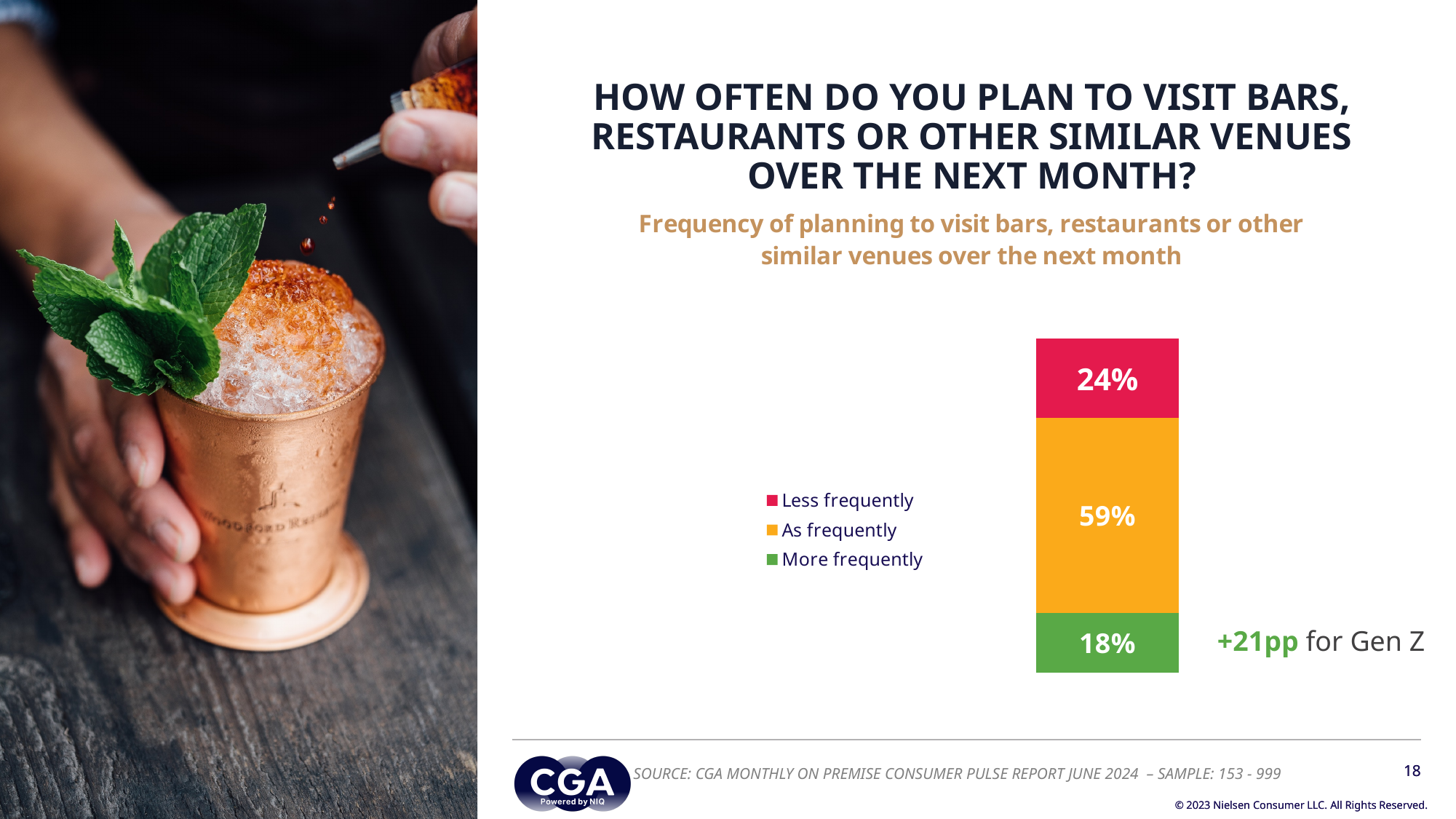
Which is larger: the share for 'Less frequently' or the share for 'More frequently'? Less frequently What percentage of respondents plan to visit as frequently over the next month? 59% Which response category has the largest share in the stacked bar? As frequently Which response category has the smallest share in the stacked bar? More frequently What is the difference in percentage points between 'As frequently' and 'Less frequently'? 35 Which colour represents 'As frequently' in the chart? Orange What percentage of respondents plan to visit more frequently over the next month? 18% What percentage of respondents plan to visit bars, restaurants or similar venues less frequently over the next month? 24% What is the total of the three segments in the stacked bar? 101% How many series does the legend list? 3 What kind of chart is shown on the slide? Stacked bar chart What is the difference in percentage points between 'Less frequently' and 'More frequently'? 6